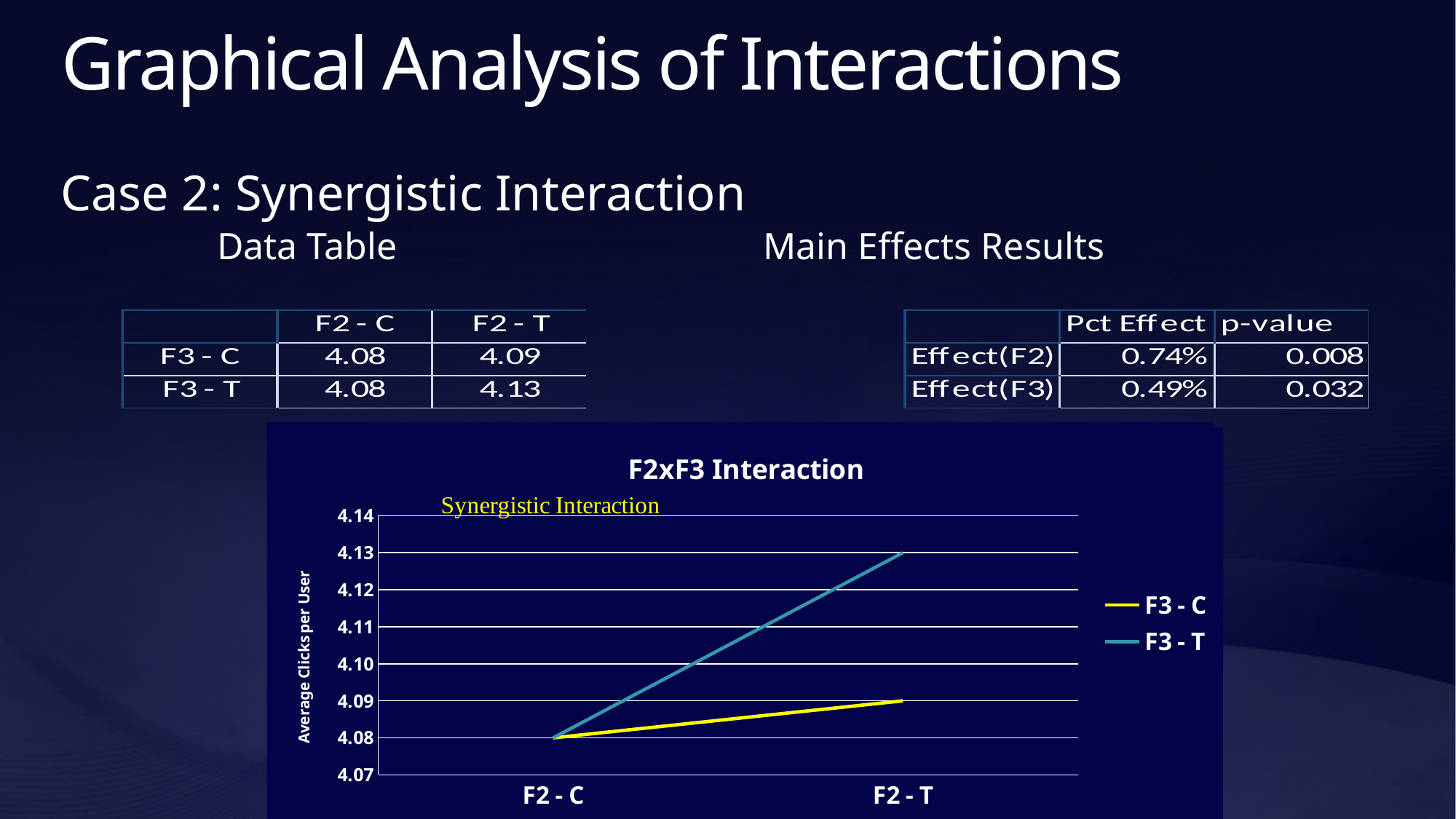
Does the F3 - T series rise or fall from F2 - C to F2 - T? rise How many categories are shown on the x axis of the chart? 2 What is the value of the F3 - C series at F2 - C? 4.08 What type of chart is shown on the slide? line chart What is the difference between the F3 - T and F3 - C values at F2 - T? 0.04 What is the title of the chart? F2xF3 Interaction What is the value of the F3 - C series at F2 - T? 4.09 What is the label of the y axis of the chart? Average Clicks per User Is the value of the F3 - T series at F2 - T greater or less than 4.10? greater What is the value of the F3 - T series at F2 - T? 4.13 Which series has the higher value at F2 - T? F3 - T How many series does the chart legend list? 2